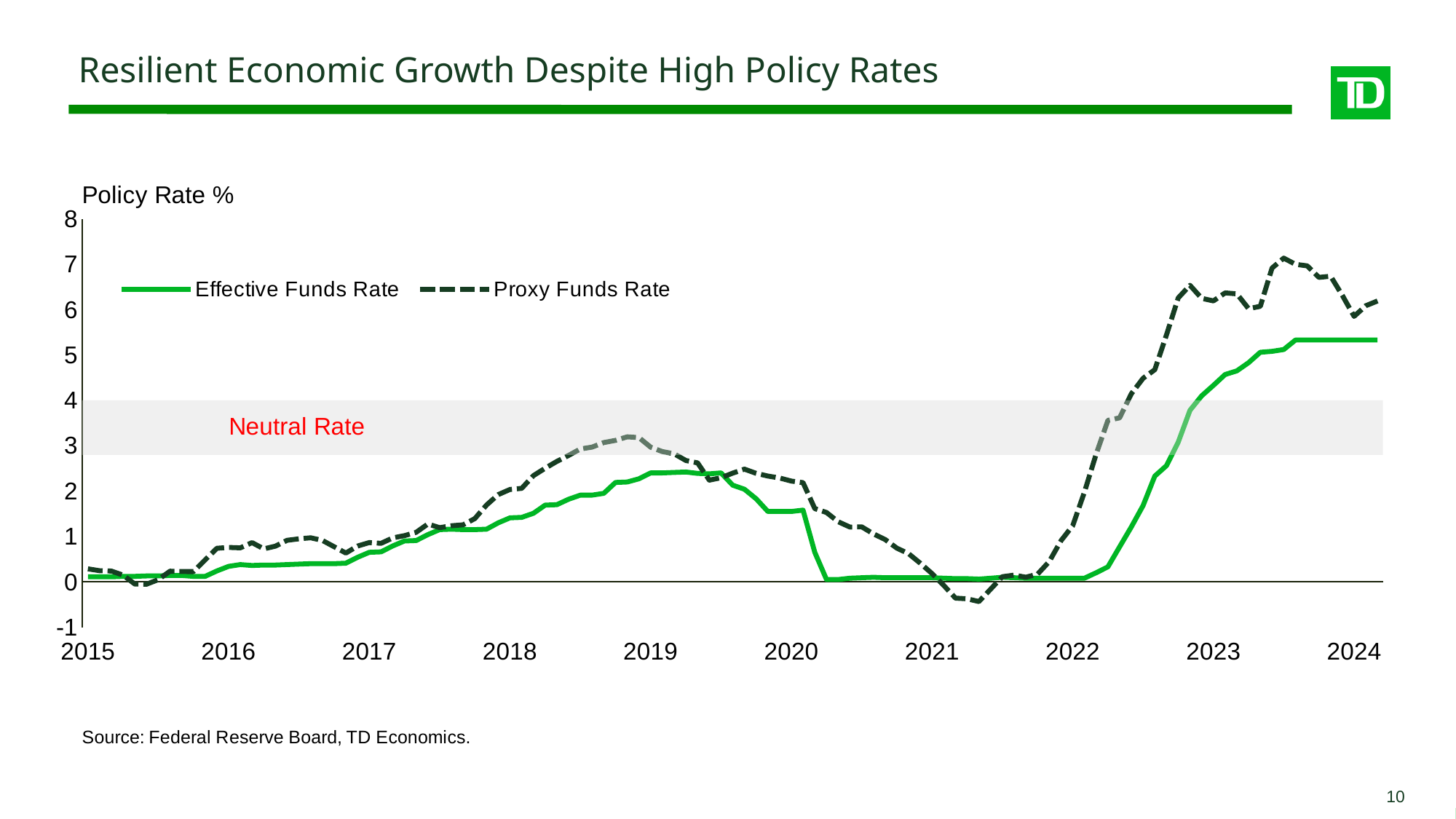
How many series does the legend list? 2 Is the Effective Funds Rate at the start of 2024 greater or less than 5? greater Is the Proxy Funds Rate at the start of 2023 greater or less than 6? greater How many year labels are shown on the x axis? 10 Does the Effective Funds Rate rise or fall between 2022 and 2023? rise Is the Effective Funds Rate at the start of 2019 greater or less than 2? greater What kind of chart is shown on the slide? line chart What label is shown on the shaded band between 3 and 4 on the y axis? Neutral Rate Which series is higher at the start of 2019, the Effective Funds Rate or the Proxy Funds Rate? Proxy Funds Rate What is the title of the slide? Resilient Economic Growth Despite High Policy Rates Which series is higher at the start of 2024, the Effective Funds Rate or the Proxy Funds Rate? Proxy Funds Rate